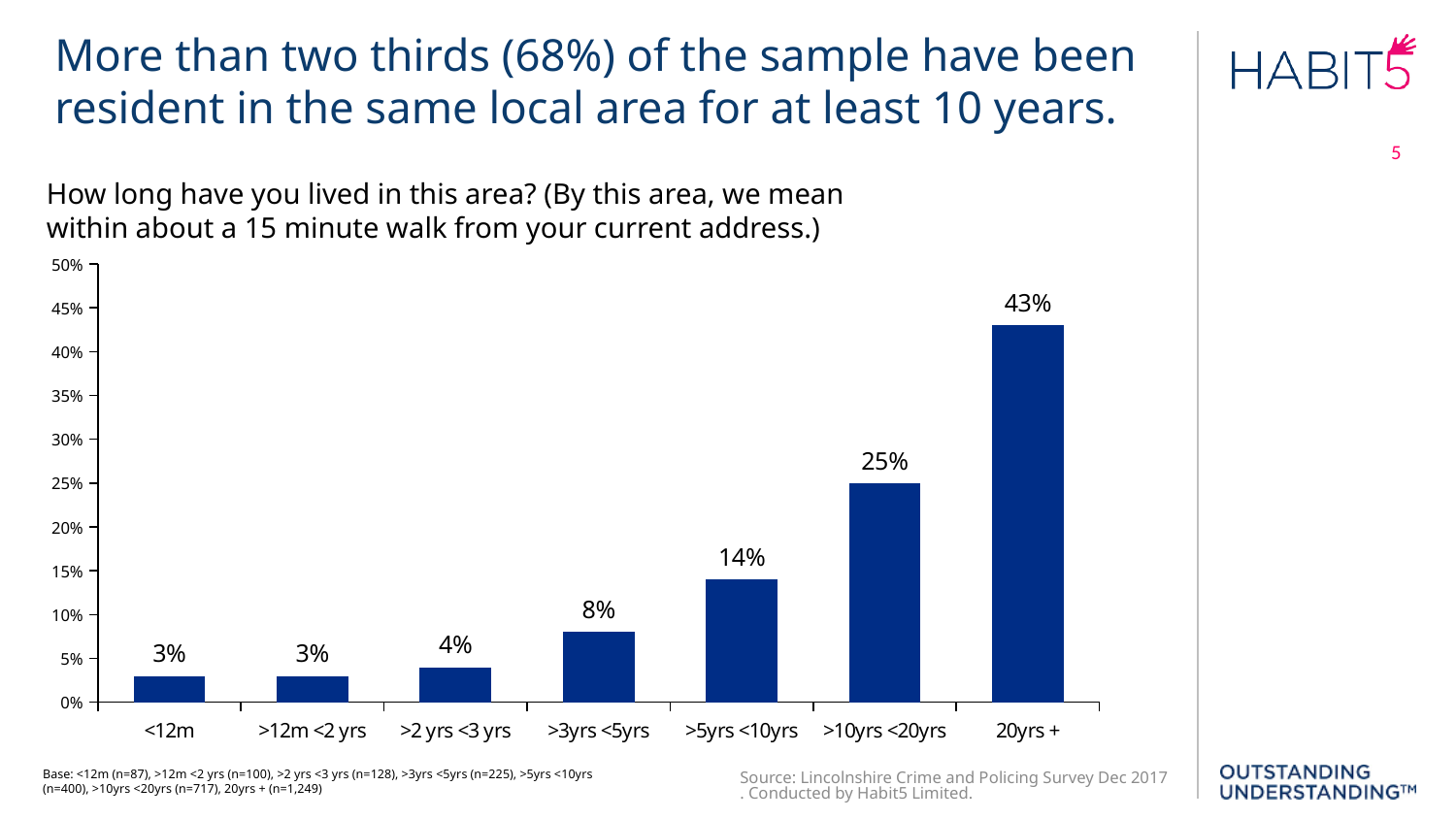
What is the maximum value shown on the y axis? 50% Which category has the highest value? 20yrs + Is the value for >10yrs <20yrs greater or less than 20%? greater Do the values generally rise or fall from left to right along the x axis? rise Which is larger, the value for >2 yrs <3 yrs or the value for >3yrs <5yrs? >3yrs <5yrs How many categories are shown on the x axis? 7 What is the value for the >3yrs <5yrs category? 8% What is the difference between the values for 20yrs + and >10yrs <20yrs? 18% What is the combined value of the >10yrs <20yrs and 20yrs + categories? 68% What is the value for the >5yrs <10yrs category? 14% What kind of chart is shown on the slide? bar chart What percentage of respondents have lived in the area for 20yrs +? 43%